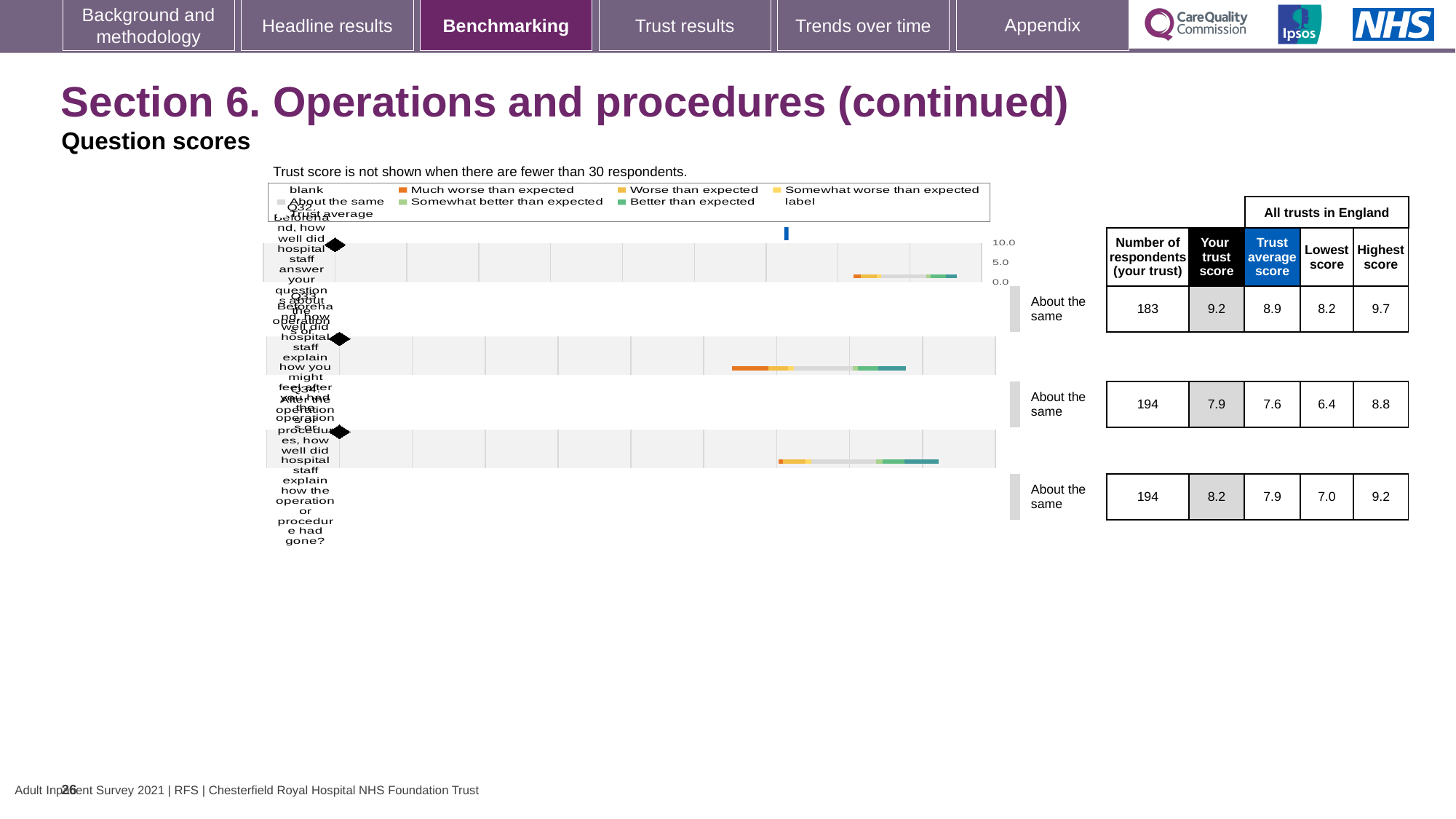
How many question rows (charts) are shown in the benchmarking section on this slide? 3 In the benchmarking table, what is the lowest score across all trusts in England for the second question row (Q33)? 6.4 In the benchmarking table, what is the number of respondents for the first question row (Q32)? 183 What benchmark category is shown next to each of the three question charts? About the same In the benchmarking table, what is the trust average score for the second question row (Q33)? 7.6 Which question row has the highest 'Your trust score' in the benchmarking table? The first row (Q32), 9.2 For the second question row (Q33), is 'Your trust score' higher or lower than the trust average score? higher Which question row has the lowest trust average score in the benchmarking table? The second row (Q33), 7.6 In the benchmarking table, what is 'Your trust score' for the first question row (Q32)? 9.2 According to the note above the charts, the trust score is not shown when there are fewer than how many respondents? 30 For the third question row (Q34), what is the difference between 'Your trust score' and the trust average score? 0.3 In the benchmarking table, what is the highest score across all trusts in England for the third question row (Q34)? 9.2